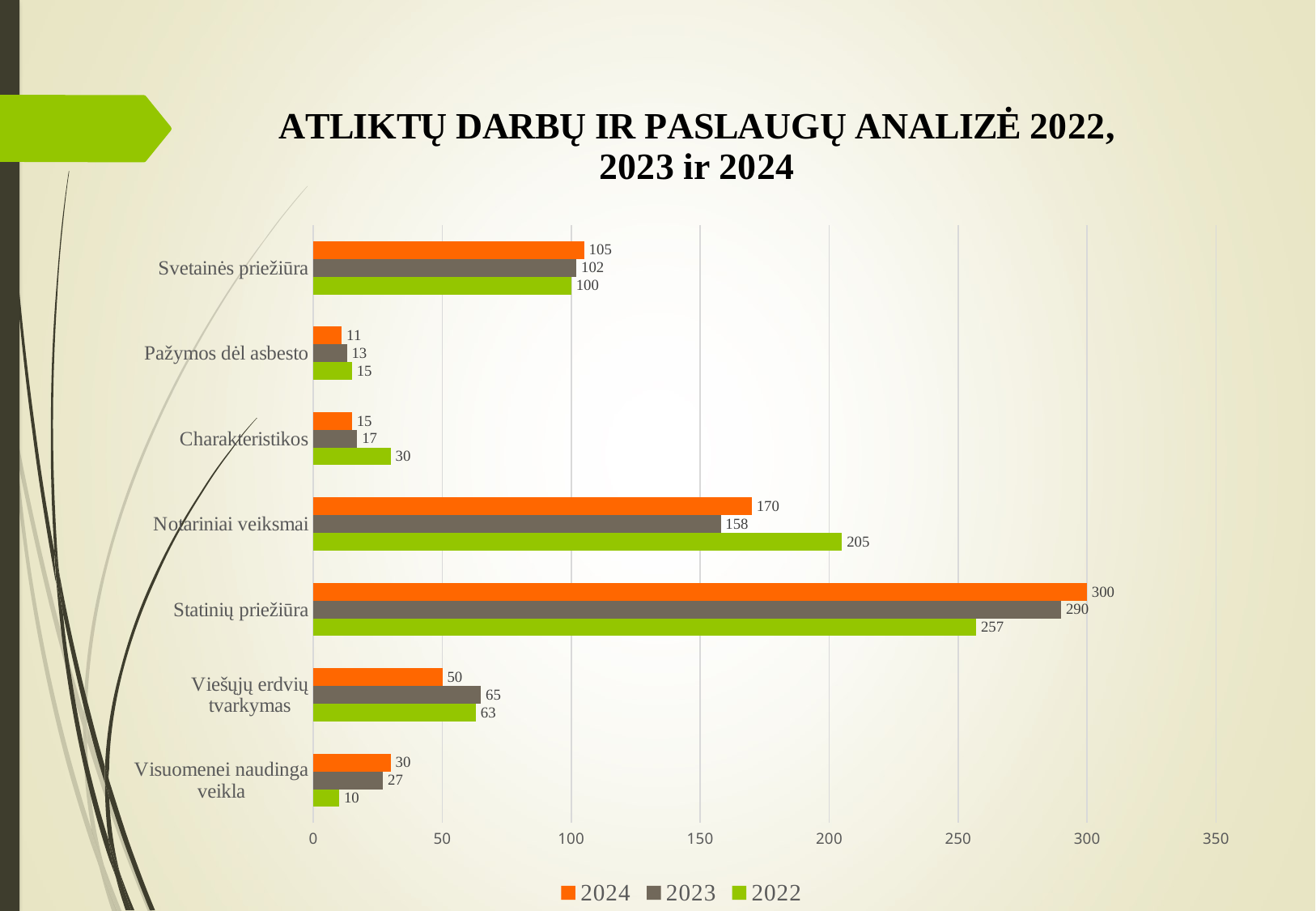
What is the difference between the 2022 and 2023 values for Notariniai veiksmai? 47 How many series does the legend list? 3 How many categories are shown on the chart? 7 Which category has the highest value in 2023? Statinių priežiūra Which category has the lowest value in 2022? Visuomenei naudinga veikla What is the value for Viešųjų erdvių tvarkymas in 2023? 65 What is the difference between the 2024 and 2022 values for Svetainės priežiūra? 5 Which is larger for Charakteristikos: the 2022 value or the 2024 value? 2022 What is the value for Statinių priežiūra in 2024? 300 What is the value for Notariniai veiksmai in 2022? 205 What kind of chart is shown on the slide? Bar chart Which series is shown in orange in the legend? 2024